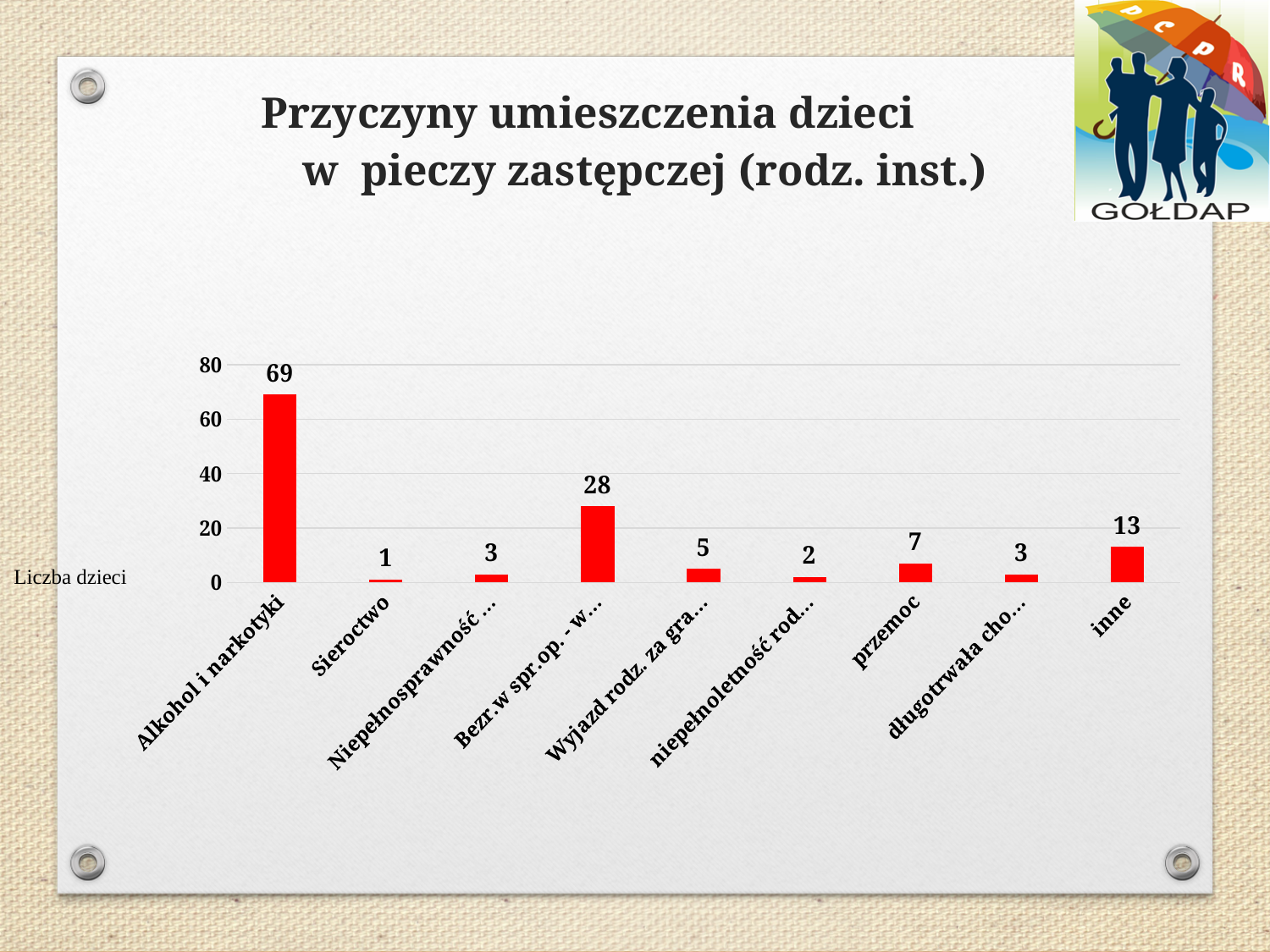
What kind of chart is shown on the slide? bar chart Which category has the lowest value? Sieroctwo Which category has the highest value? Alkohol i narkotyki What is the label shown next to the vertical axis? Liczba dzieci What is the value for "Sieroctwo"? 1 What is the value for "inne"? 13 What is the value for "Alkohol i narkotyki"? 69 What is the difference between the values for "Alkohol i narkotyki" and "inne"? 56 What is the value for "przemoc"? 7 Is the value for "Alkohol i narkotyki" greater or less than 60? greater How many categories are shown on the x axis? 9 Which is larger, the value for "przemoc" or the value for "inne"? inne